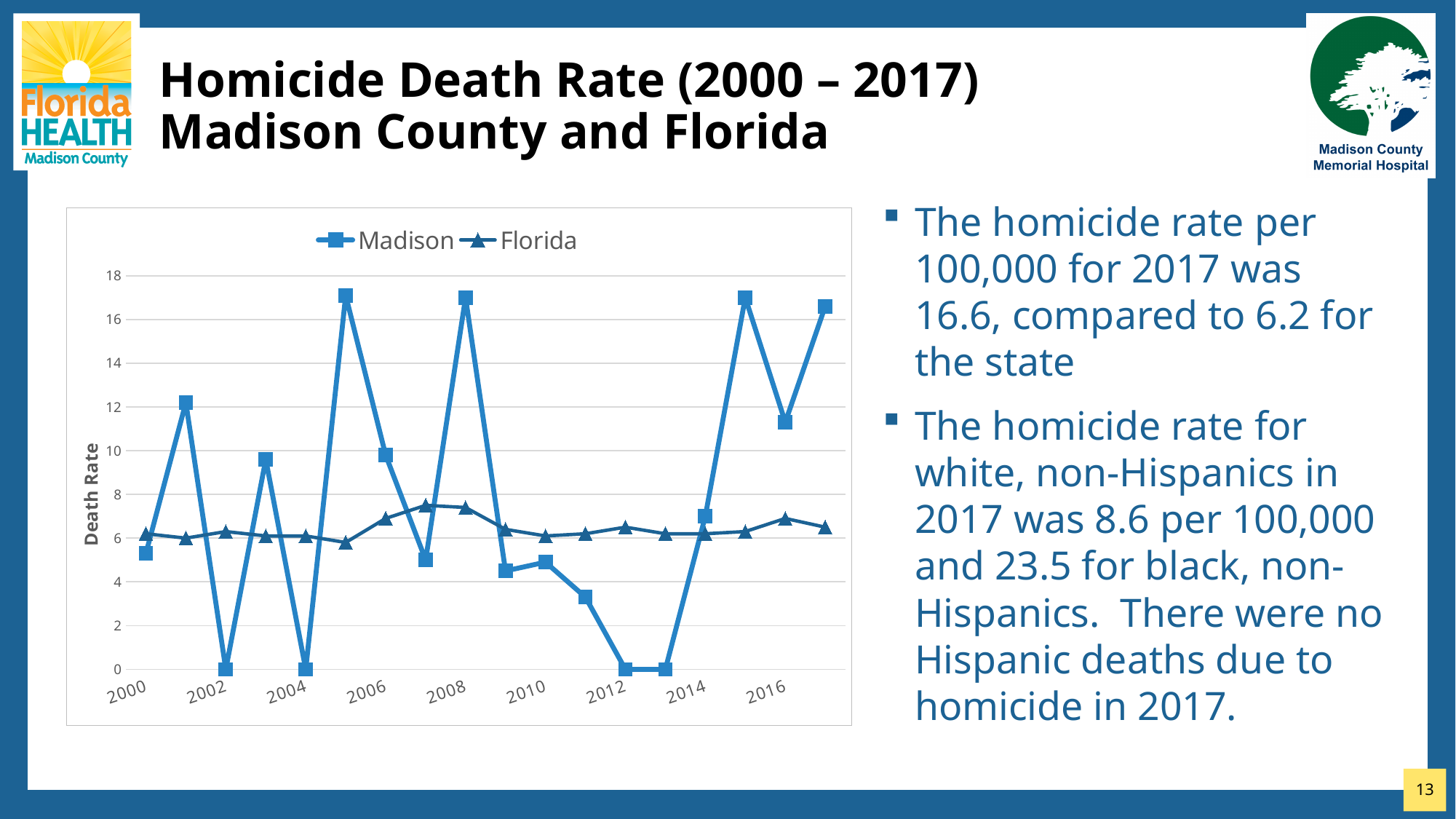
What is the difference between the Madison and Florida homicide death rates in 2017? 10.4 What is the Florida homicide death rate for 2017? 6.2 What is the label on the vertical axis of the chart? Death Rate What is the Madison homicide death rate for 2017? 16.6 What kind of chart is shown on the slide? line chart How many series does the chart legend list? 2 What is the Madison homicide death rate for 2012? 0 How many years are plotted for each series in the chart? 18 Is the Madison value for 2005 greater or less than 16? greater Which two series are listed in the chart legend? Madison and Florida What is the Madison homicide death rate for 2002? 0 Which series has the larger value in 2012, Madison or Florida? Florida